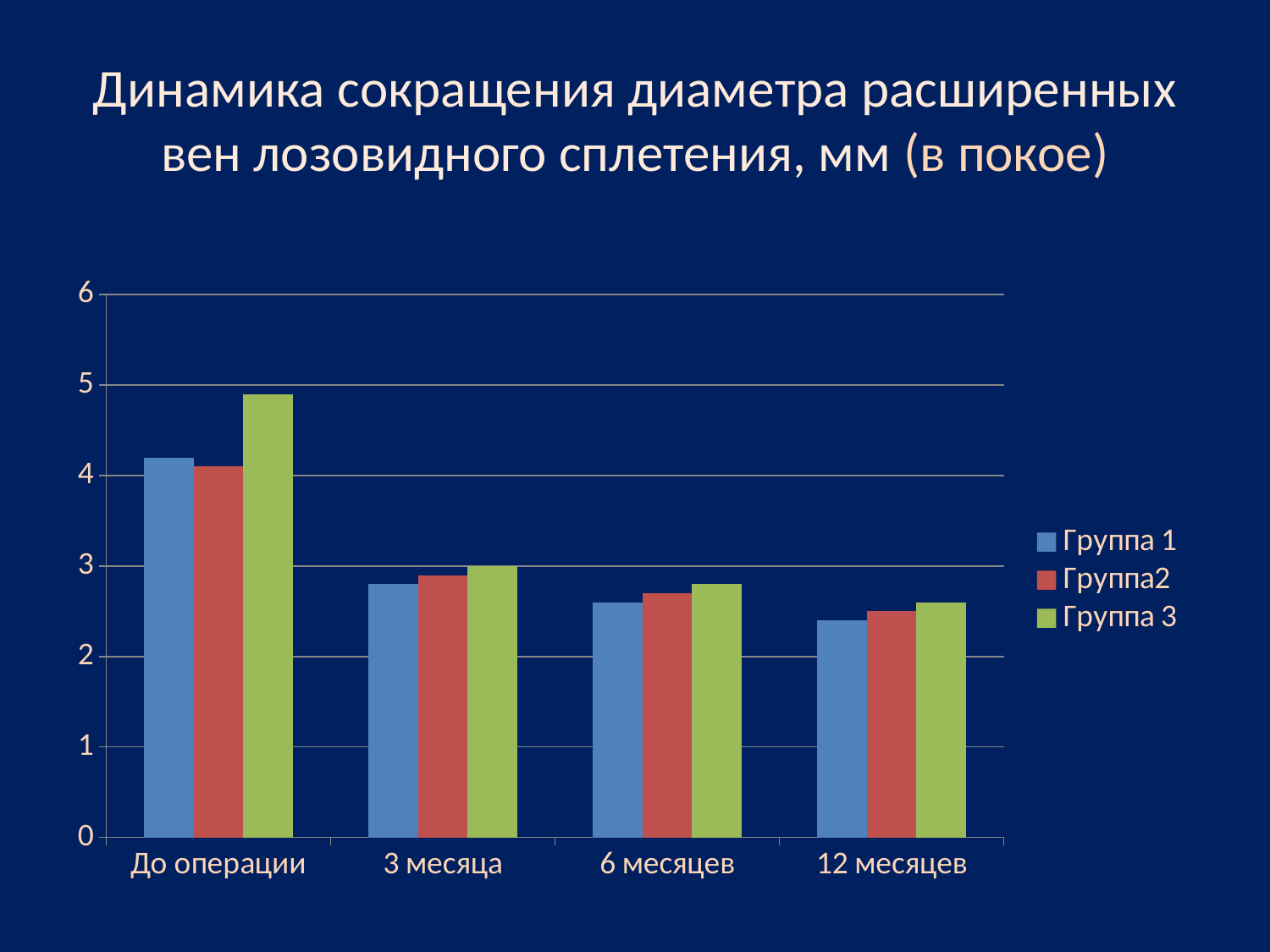
Is the value for Группа 3 in the 'До операции' category greater or less than 4? greater Which category has the highest values for all three groups? До операции What colour are the bars for Группа 3? green How many categories are shown on the x axis? 4 Do the values for Группа 1 rise or fall from 'До операции' to '12 месяцев'? fall Which group has the lowest value in the '12 месяцев' category? Группа 1 Is the value for Группа 1 in the '12 месяцев' category greater or less than 3? less Which is larger: the value for Группа 3 in 'До операции' or the value for Группа 3 in '3 месяца'? До операции Is the value for Группа 2 in the '6 месяцев' category greater or less than 2? greater How many series does the legend list? 3 Which group has the highest value in the 'До операции' category? Группа 3 What kind of chart is shown on the slide? bar chart